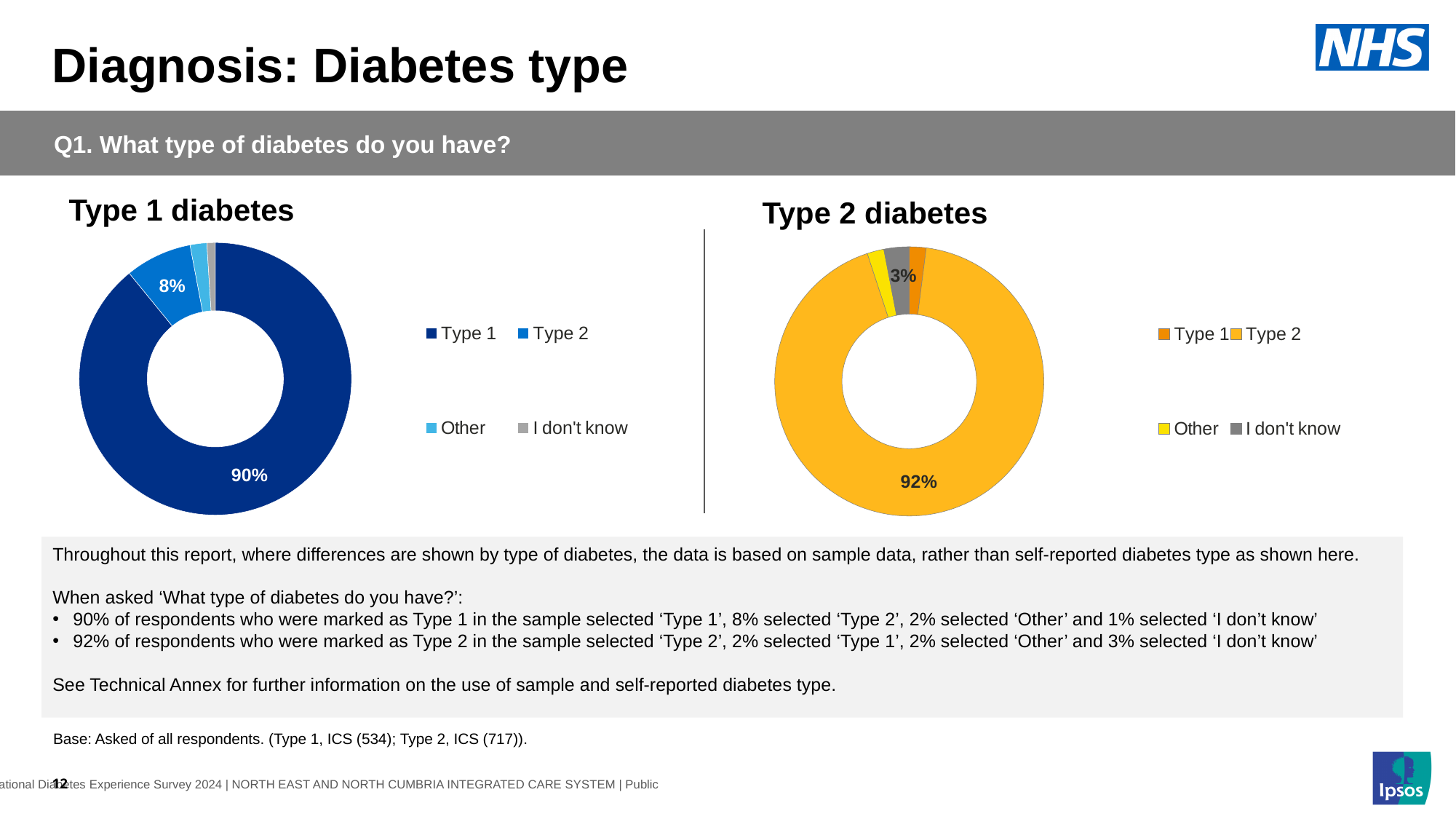
In the Type 1 diabetes chart, what is the difference in percentage points between the 'Type 1' and 'Type 2' slices? 82 percentage points What are the legend entries of the Type 2 diabetes chart? Type 1, Type 2, Other, I don't know What kind of chart is used for the Type 2 diabetes data? Pie (donut) chart Which is larger: the 'Type 1' slice in the Type 1 diabetes chart or the 'Type 2' slice in the Type 2 diabetes chart? The 'Type 2' slice in the Type 2 diabetes chart (92%) In the Type 1 diabetes chart, what percentage of respondents selected 'Type 1'? 90% In the Type 2 diabetes chart, which category has the largest slice? Type 2 In the Type 1 diabetes chart, which category has the smallest slice? I don't know In the Type 2 diabetes chart, what percentage of respondents selected 'Type 2'? 92% How many categories does the legend of the Type 1 diabetes chart list? 4 In the Type 1 diabetes chart, which category has the largest slice? Type 1 In the Type 1 diabetes chart, what percentage of respondents selected 'Type 2'? 8% In the Type 2 diabetes chart, what percentage of respondents selected 'I don't know'? 3%